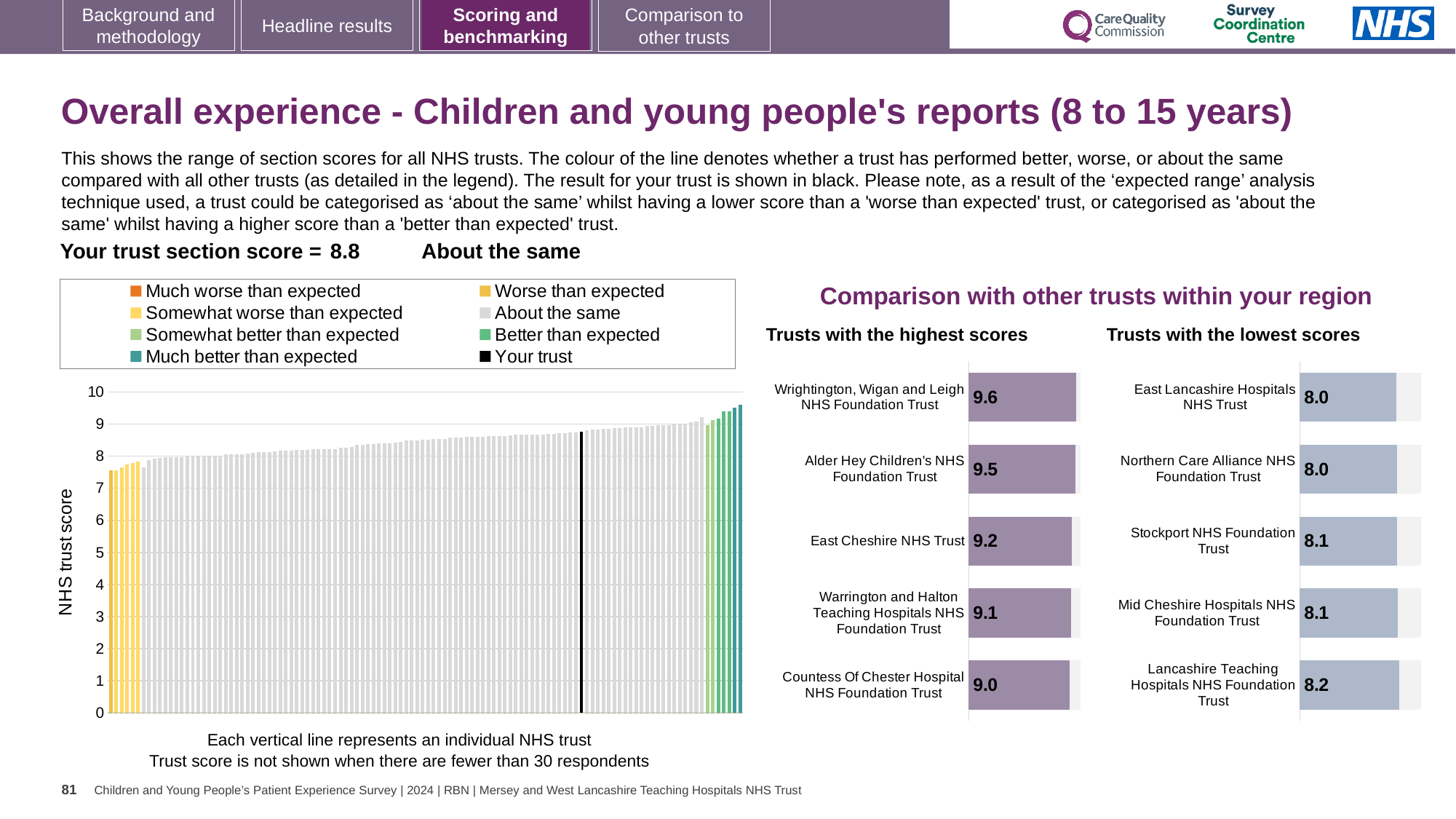
In the 'Trusts with the lowest scores' chart, which trust has the highest score? Lancashire Teaching Hospitals NHS Foundation Trust Which is larger: the score for Alder Hey Children's NHS Foundation Trust in the highest scores chart or the score for Stockport NHS Foundation Trust in the lowest scores chart? Alder Hey Children's NHS Foundation Trust In the 'Trusts with the lowest scores' chart, what is the score for Stockport NHS Foundation Trust? 8.1 In the 'Trusts with the highest scores' chart, what is the difference between the scores of Wrightington, Wigan and Leigh NHS Foundation Trust and Countess Of Chester Hospital NHS Foundation Trust? 0.6 In the 'Trusts with the highest scores' chart, what is the score for East Cheshire NHS Trust? 9.2 How many entries does the legend of the large chart on the left list? 8 In the 'Trusts with the lowest scores' chart, what is the score for Lancashire Teaching Hospitals NHS Foundation Trust? 8.2 How many trusts are shown in the 'Trusts with the lowest scores' chart? 5 In the large chart on the left, is the value for the black 'Your trust' bar greater or less than 8? greater In the 'Trusts with the highest scores' chart, which trust has the highest score? Wrightington, Wigan and Leigh NHS Foundation Trust In the 'Trusts with the highest scores' chart, what is the score for Wrightington, Wigan and Leigh NHS Foundation Trust? 9.6 In the 'Trusts with the highest scores' chart, which trust has the lowest score? Countess Of Chester Hospital NHS Foundation Trust